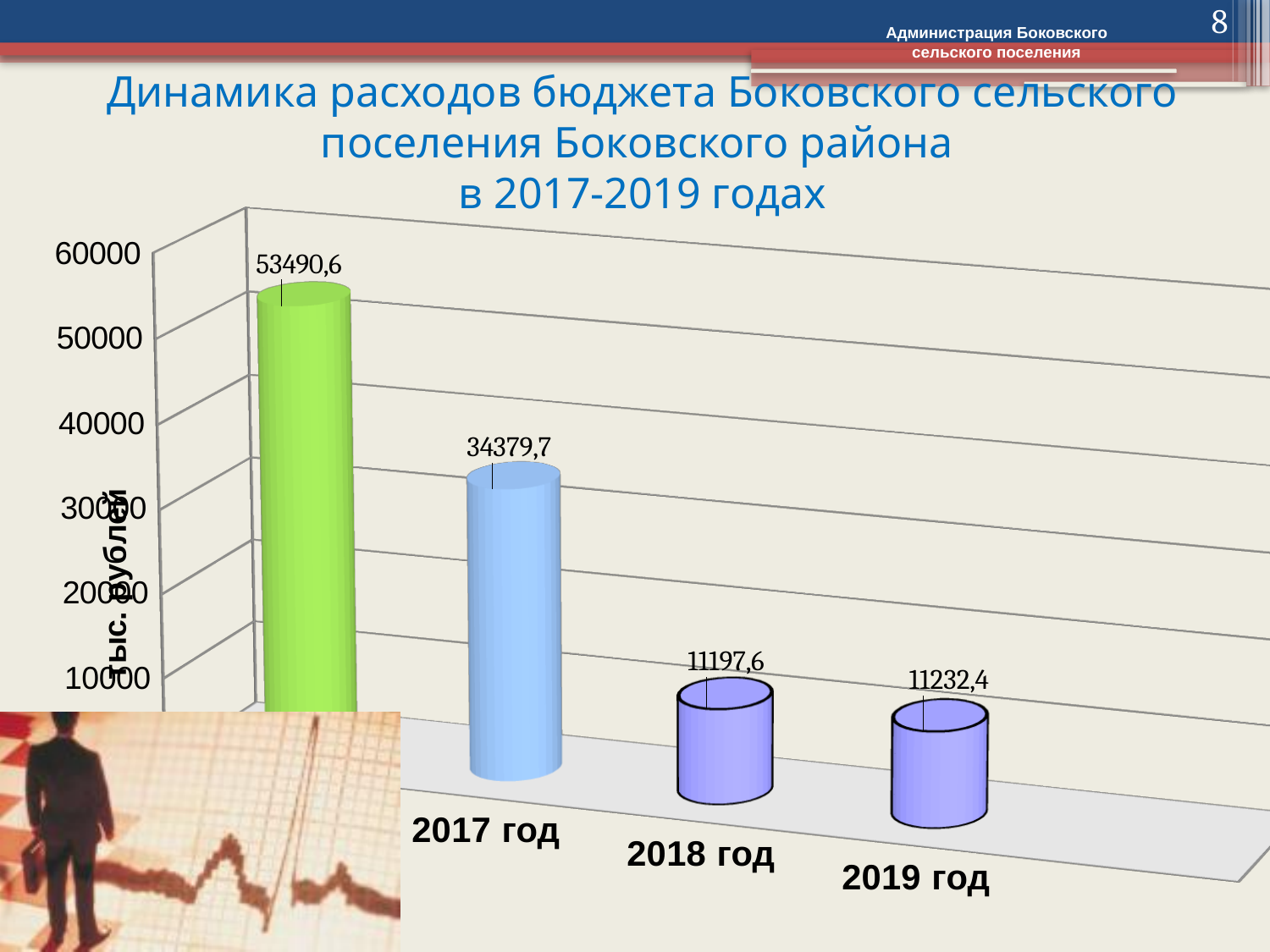
What kind of chart is shown on the slide? bar chart Is the value for 2017 год greater or less than 30000? greater What is the value for 2019 год? 11232,4 What is the difference between the values for 2017 год and 2018 год? 23182,1 What is the difference between the values for 2019 год and 2018 год? 34,8 What is the value for 2018 год? 11197,6 Which of the labelled years has the lowest value? 2018 год How many bars are plotted on the chart? 4 What unit is given on the vertical axis label? тыс. рублей Do the values rise or fall from 2017 год to 2018 год? fall What is the value for 2017 год? 34379,7 Which is larger, the value for 2019 год or the value for 2018 год? 2019 год